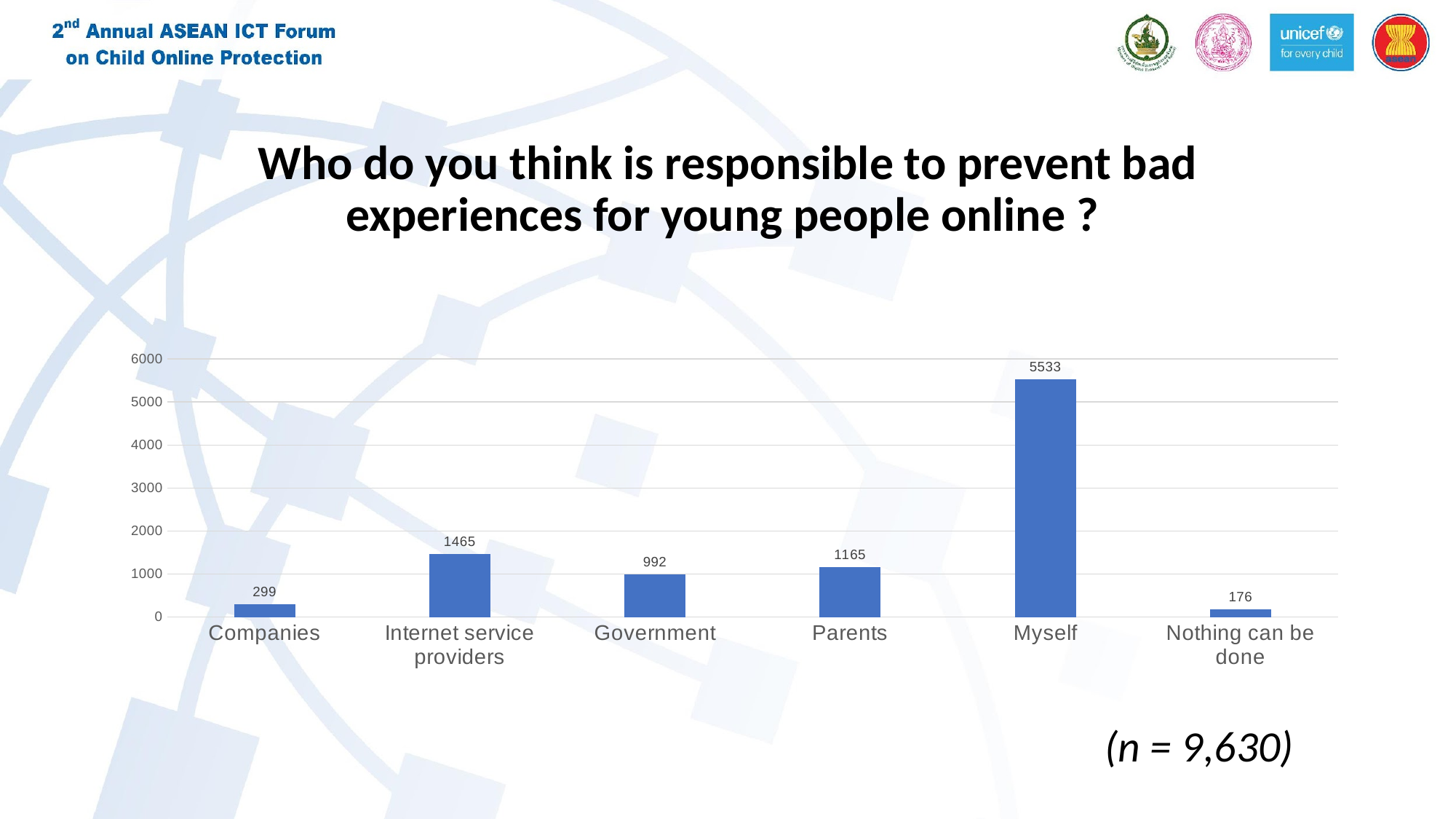
What kind of chart is shown on the slide? Bar chart Which category has the lowest value? Nothing can be done Which is larger, the value for Parents or the value for Government? Parents What is the value for Internet service providers? 1465 What is the value for Government? 992 What is the difference between the values for Companies and Nothing can be done? 123 How many categories are shown on the x axis? 6 Is the value for Myself greater or less than 5000? greater What is the value for Nothing can be done? 176 What is the value for Myself? 5533 Which category has the highest value? Myself What is the difference between the values for Internet service providers and Parents? 300